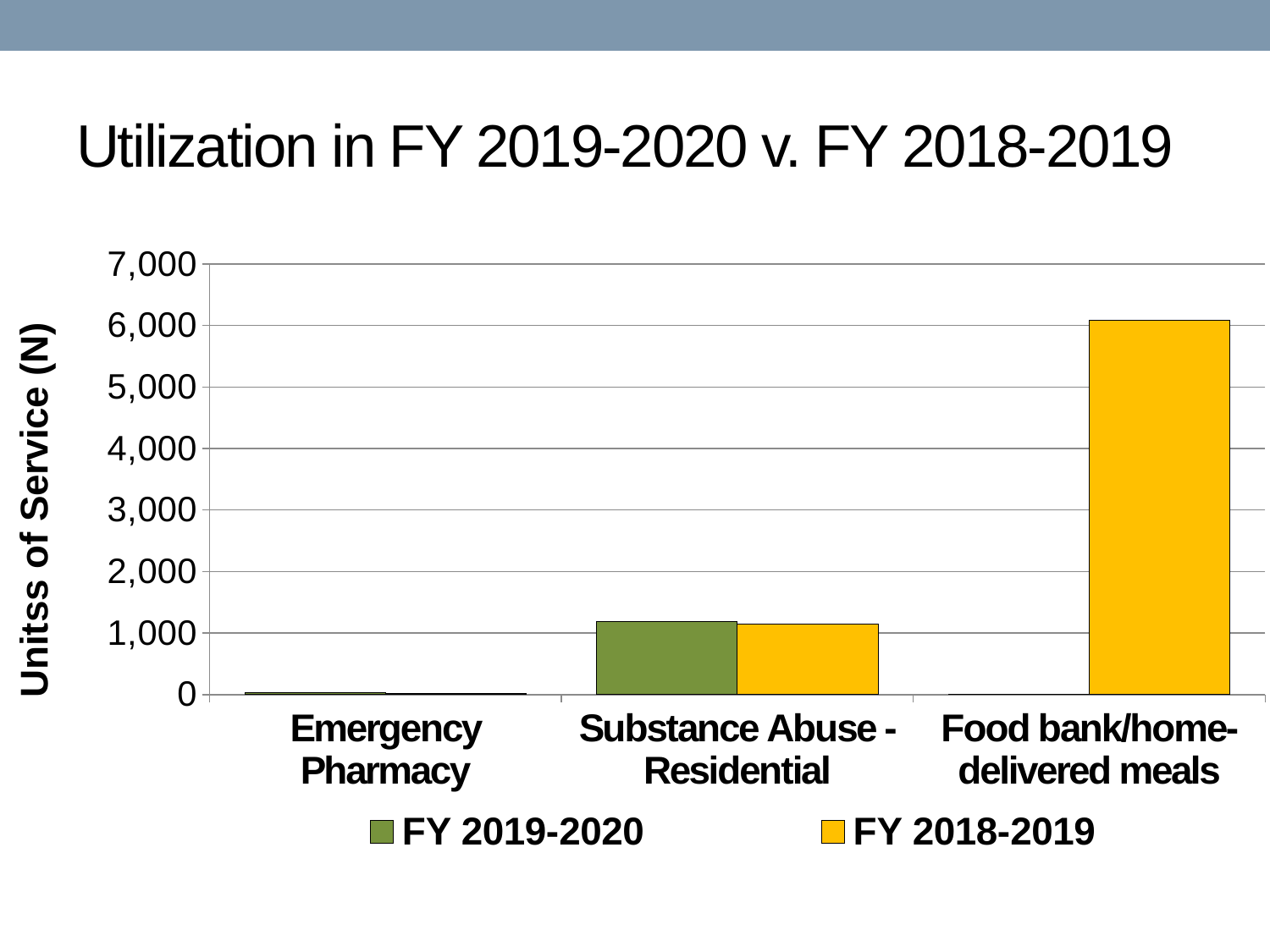
How many categories are shown on the x axis? 3 Which category has the highest value for FY 2018-2019? Food bank/home-delivered meals How many series does the legend list? 2 Which colour represents FY 2018-2019 in the legend? Yellow What kind of chart is shown on the slide? Bar chart Is the FY 2019-2020 value for Substance Abuse - Residential greater or less than 1,000? greater Is the FY 2018-2019 value for Food bank/home-delivered meals greater or less than 7,000? less For FY 2018-2019, which is larger: Food bank/home-delivered meals or Substance Abuse - Residential? Food bank/home-delivered meals What is the title of the chart? Utilization in FY 2019-2020 v. FY 2018-2019 Is the FY 2018-2019 value for Emergency Pharmacy greater or less than 1,000? less